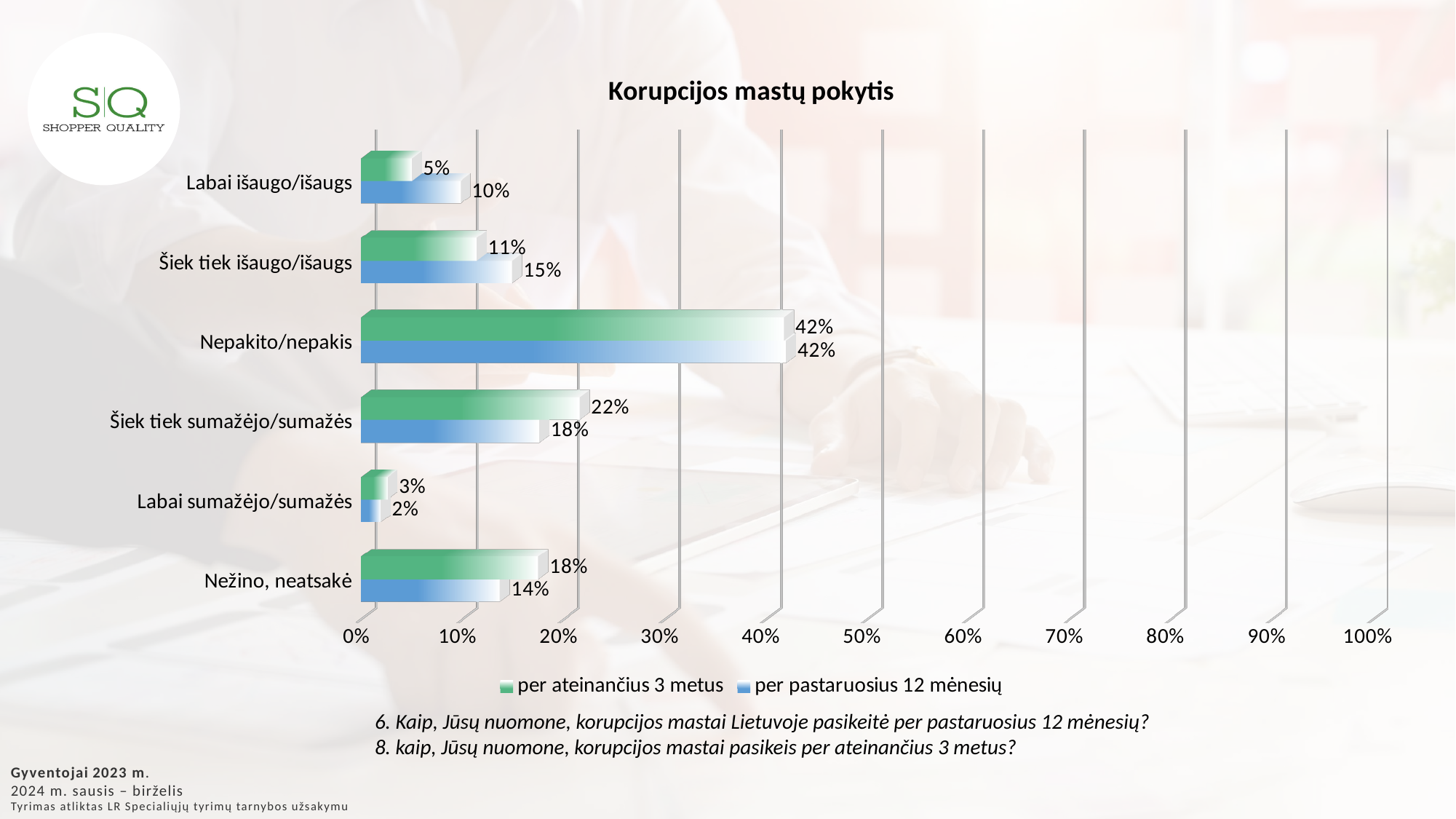
Is the value for "Nepakito/nepakis" in the "per ateinančius 3 metus" series greater or less than 30%? greater How many series does the legend list? 2 What kind of chart is shown on the slide? Bar chart What is the value for "Nepakito/nepakis" in the "per ateinančius 3 metus" series? 42% For "Nežino, neatsakė", which series has the larger value: "per ateinančius 3 metus" or "per pastaruosius 12 mėnesių"? per ateinančius 3 metus How many categories are shown on the chart? 6 What is the value for "Labai išaugo/išaugs" in the "per pastaruosius 12 mėnesių" series? 10% Which category has the lowest value in the "per ateinančius 3 metus" series? Labai sumažėjo/sumažės What is the value for "Šiek tiek sumažėjo/sumažės" in the "per ateinančius 3 metus" series? 22% Which category has the highest value in the "per pastaruosius 12 mėnesių" series? Nepakito/nepakis What is the difference between the "per ateinančius 3 metus" and "per pastaruosius 12 mėnesių" values for "Šiek tiek išaugo/išaugs"? 4% What is the title of the chart? Korupcijos mastų pokytis